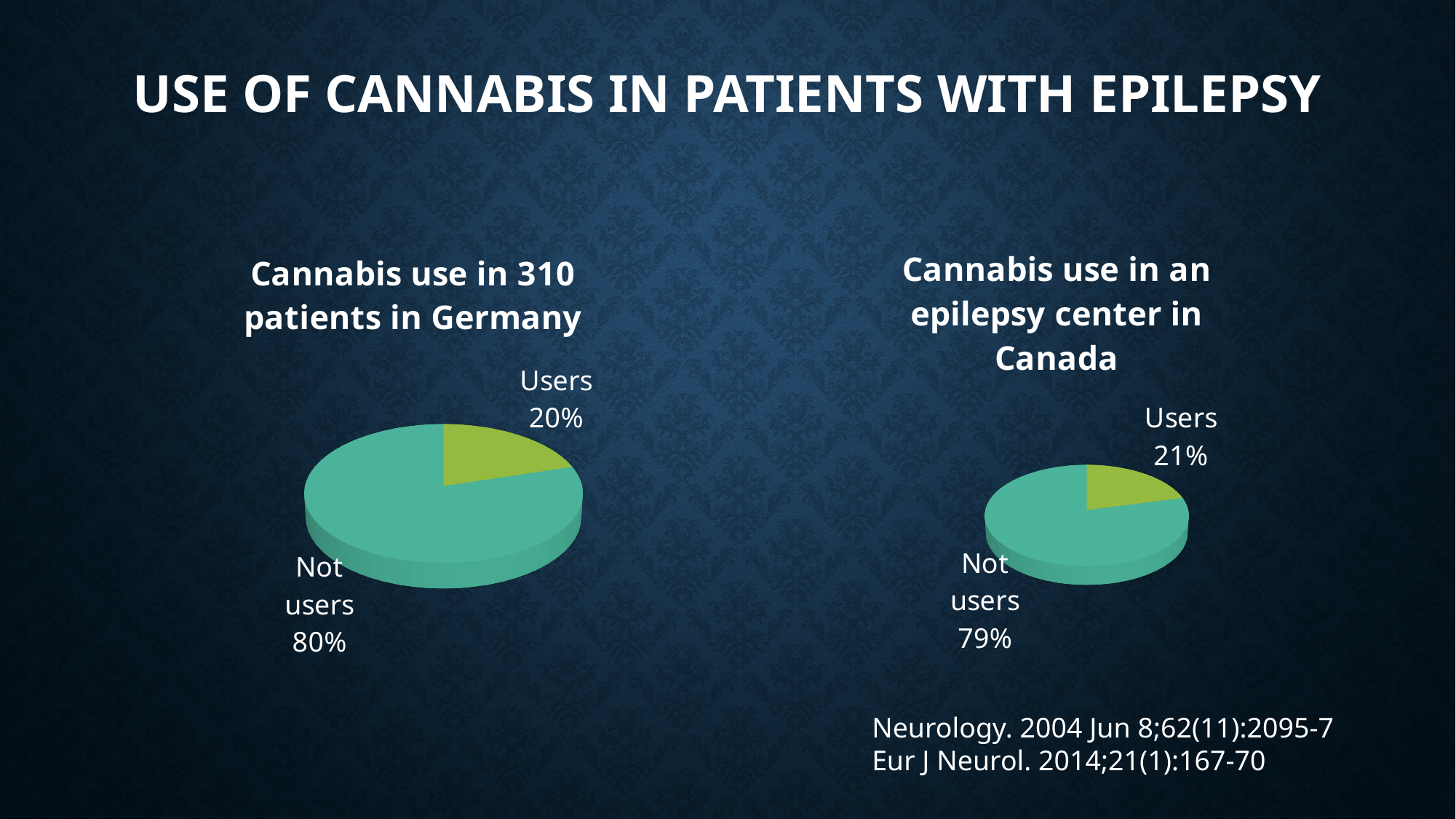
In the chart titled 'Cannabis use in 310 patients in Germany', what percentage are Users? 20% In the chart titled 'Cannabis use in an epilepsy center in Canada', what percentage are Not users? 79% In the chart titled 'Cannabis use in 310 patients in Germany', what is the difference in percentage points between Not users and Users? 60 In the chart titled 'Cannabis use in an epilepsy center in Canada', what percentage are Users? 21% In the chart titled 'Cannabis use in 310 patients in Germany', what percentage are Not users? 80% In the chart titled 'Cannabis use in 310 patients in Germany', which slice is the largest? Not users In the chart titled 'Cannabis use in an epilepsy center in Canada', what is the difference in percentage points between Not users and Users? 58 How many slices does the chart titled 'Cannabis use in an epilepsy center in Canada' have? 2 In the chart titled 'Cannabis use in an epilepsy center in Canada', which slice is the smallest? Users What type of chart is used in the chart titled 'Cannabis use in 310 patients in Germany'? Pie chart How many pie charts are shown on the slide? 2 Which chart shows a higher percentage of Users, the Germany chart or the Canada chart? Canada